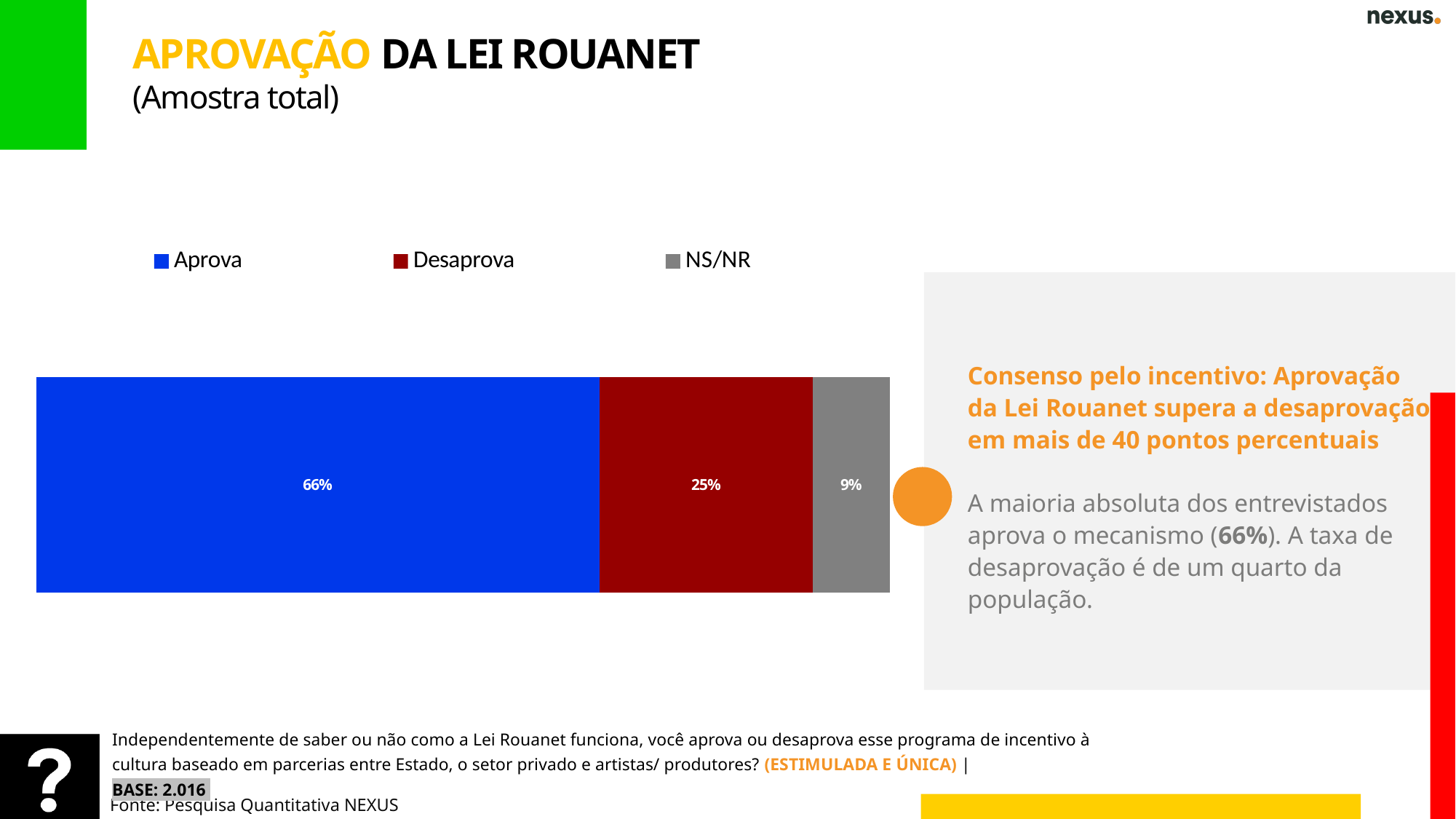
What is the value shown for NS/NR? 9% What percentage of respondents approve (Aprova) the Lei Rouanet? 66% What percentage of respondents disapprove (Desaprova) the Lei Rouanet? 25% What is the total of the three segments in the stacked bar? 100% Which segment of the bar has the highest value? Aprova What colour represents Desaprova in the chart? Dark red Which is larger, Desaprova or NS/NR? Desaprova What is the difference in percentage points between Aprova and Desaprova? 41 What is the base (number of respondents) stated on the slide? 2.016 How many series does the legend list? 3 Which segment of the bar has the lowest value? NS/NR What kind of chart is shown on the slide? Stacked bar chart